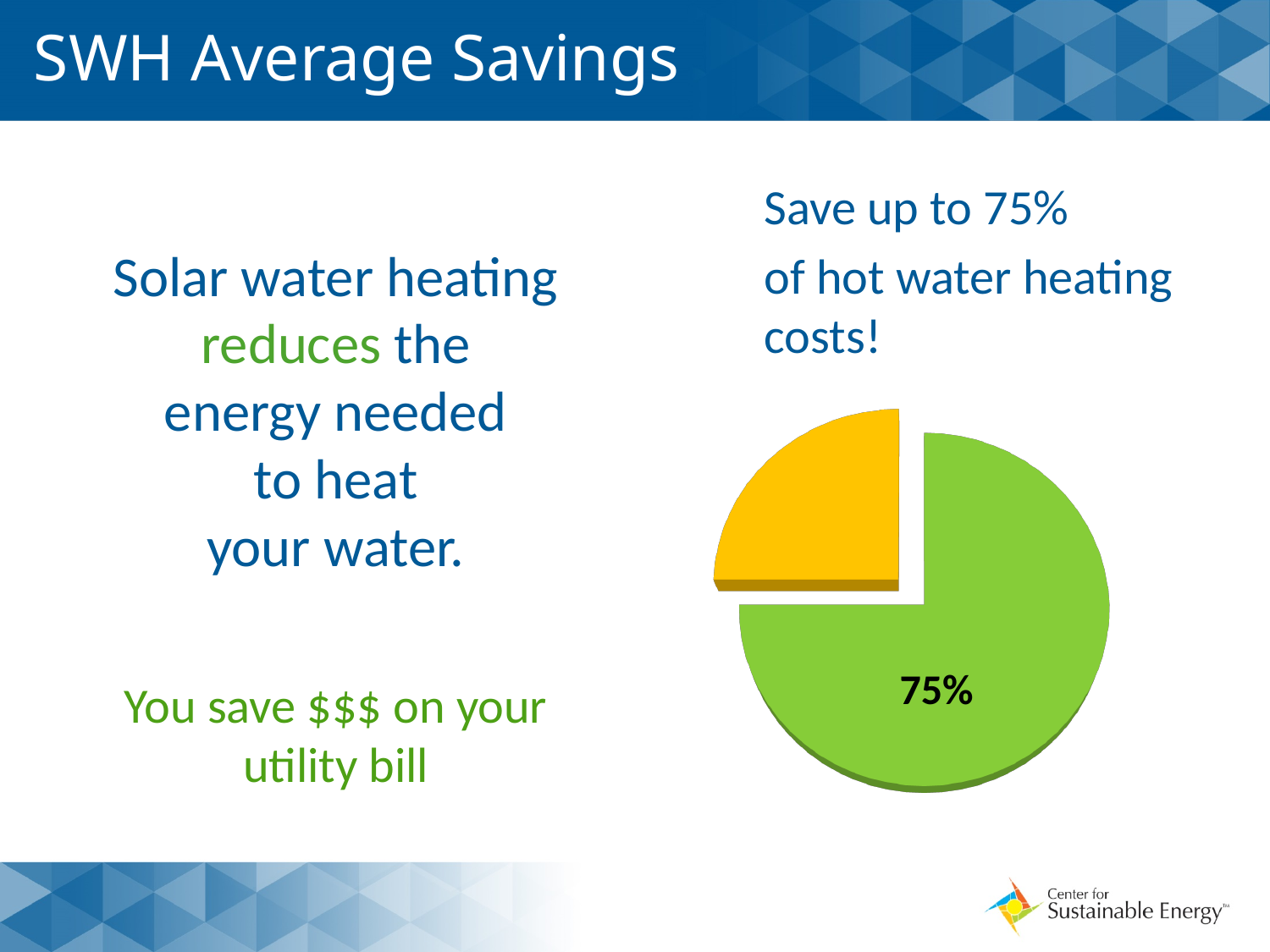
Does the pie chart have a legend? No Which colour slice is the largest in the pie chart? green How many slices does the pie chart have? 2 What kind of chart is shown on the slide? pie chart Which slice of the pie chart is pulled out (exploded) from the rest of the pie? the yellow slice What colour is the slice labelled 75% in the pie chart? green What share of the pie does the green slice represent? 75% Which colour slice is the smallest in the pie chart? yellow What value is labelled on the green slice of the pie chart? 75% Which slice of the pie chart is larger, the green one or the yellow one? green